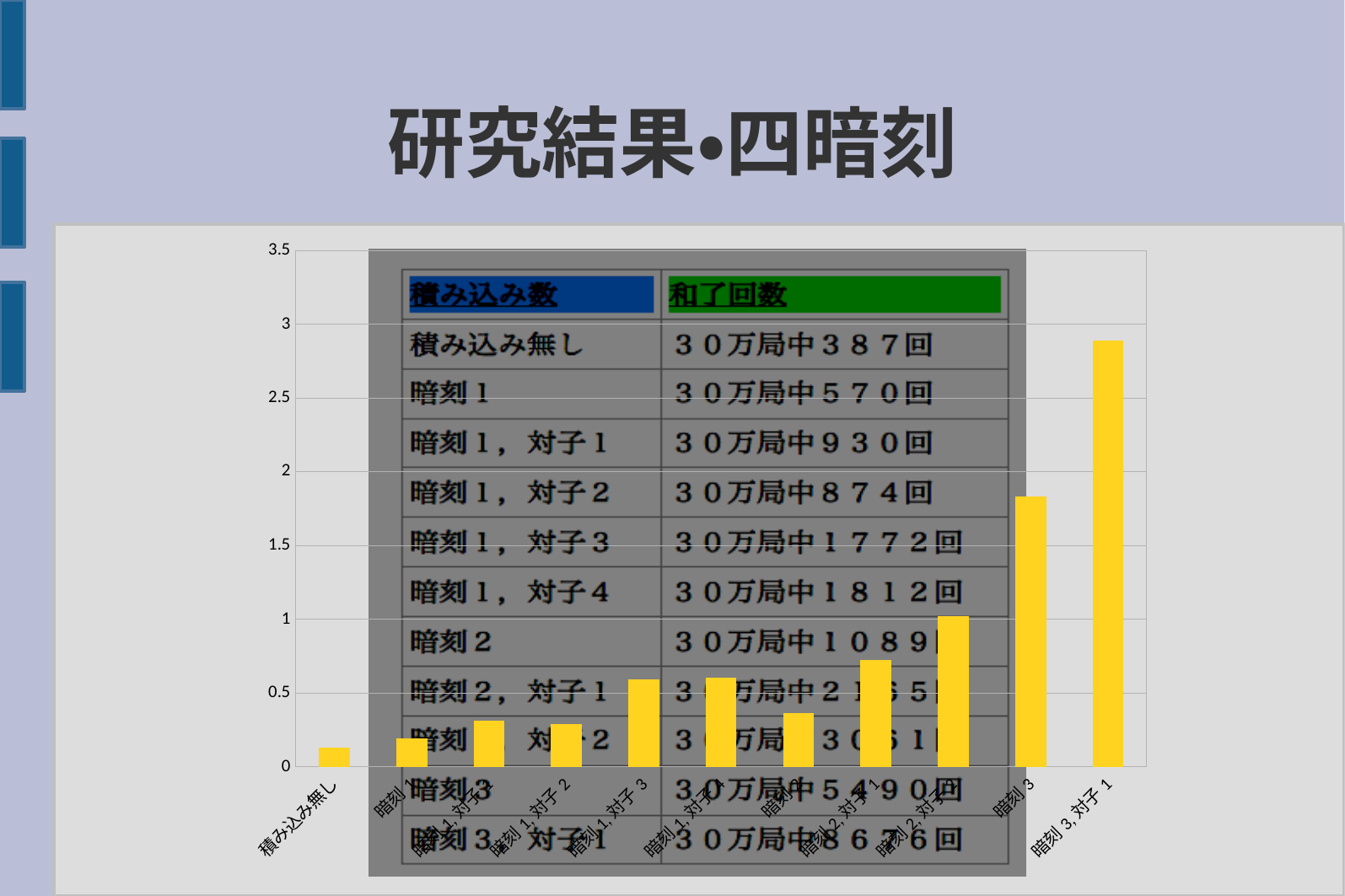
Which is larger, the value for 暗刻3 or the value for 暗刻2,対子2? 暗刻3 Which is larger, the value for 暗刻1,対子3 or the value for 暗刻2? 暗刻1,対子3 How many categories (bars) does the chart show? 11 Is the value for 暗刻3 greater or less than 1.5? greater What colour are the bars in the chart? yellow Is the value for 積み込み無し greater or less than 0.5? less Which category has the highest bar in the chart? 暗刻3,対子1 What kind of chart is shown on the slide? bar chart Is the value for 暗刻2,対子1 greater or less than 1? less What is the highest value shown on the vertical axis of the chart? 3.5 Which category has the lowest bar in the chart? 積み込み無し